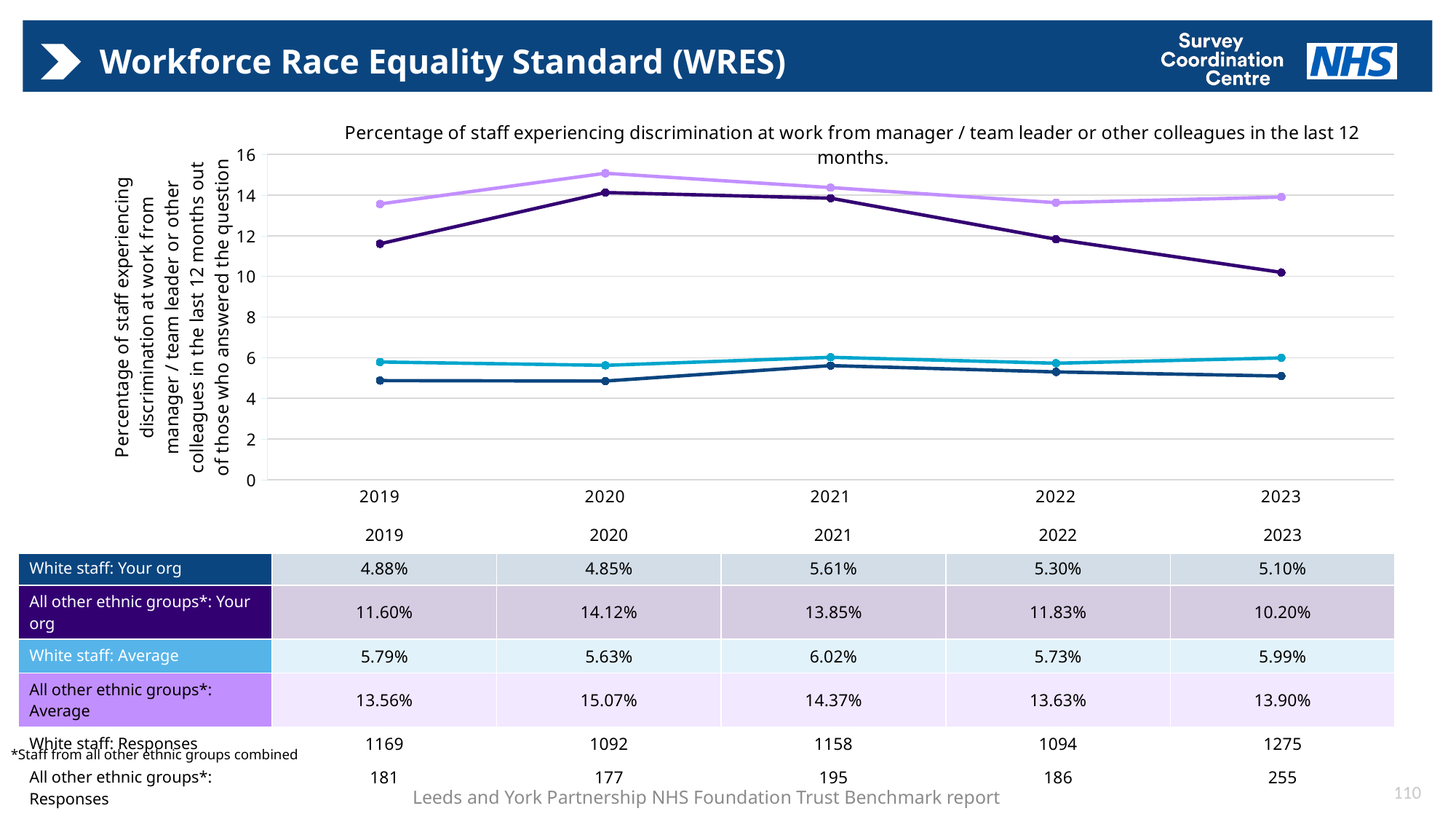
Is the value for 'All other ethnic groups*: Average' in 2020 greater or less than 14? greater What is the value for 'All other ethnic groups*: Average' in 2021? 14.37% In which year is the value for 'All other ethnic groups*: Your org' highest? 2020 Does the value for 'All other ethnic groups*: Your org' rise or fall from 2021 to 2023? fall Which is larger in 2019: 'White staff: Average' or 'White staff: Your org'? White staff: Average What is the value for 'All other ethnic groups*: Your org' in 2020? 14.12% In which year is the value for 'All other ethnic groups*: Your org' lowest? 2023 What is the difference between 'All other ethnic groups*: Average' and 'All other ethnic groups*: Your org' in 2023? 3.70% How many years are plotted along the x axis of the chart? 5 How many series are plotted in the chart? 4 What type of chart is shown on the slide? line chart What is the value for 'White staff: Your org' in 2023? 5.10%